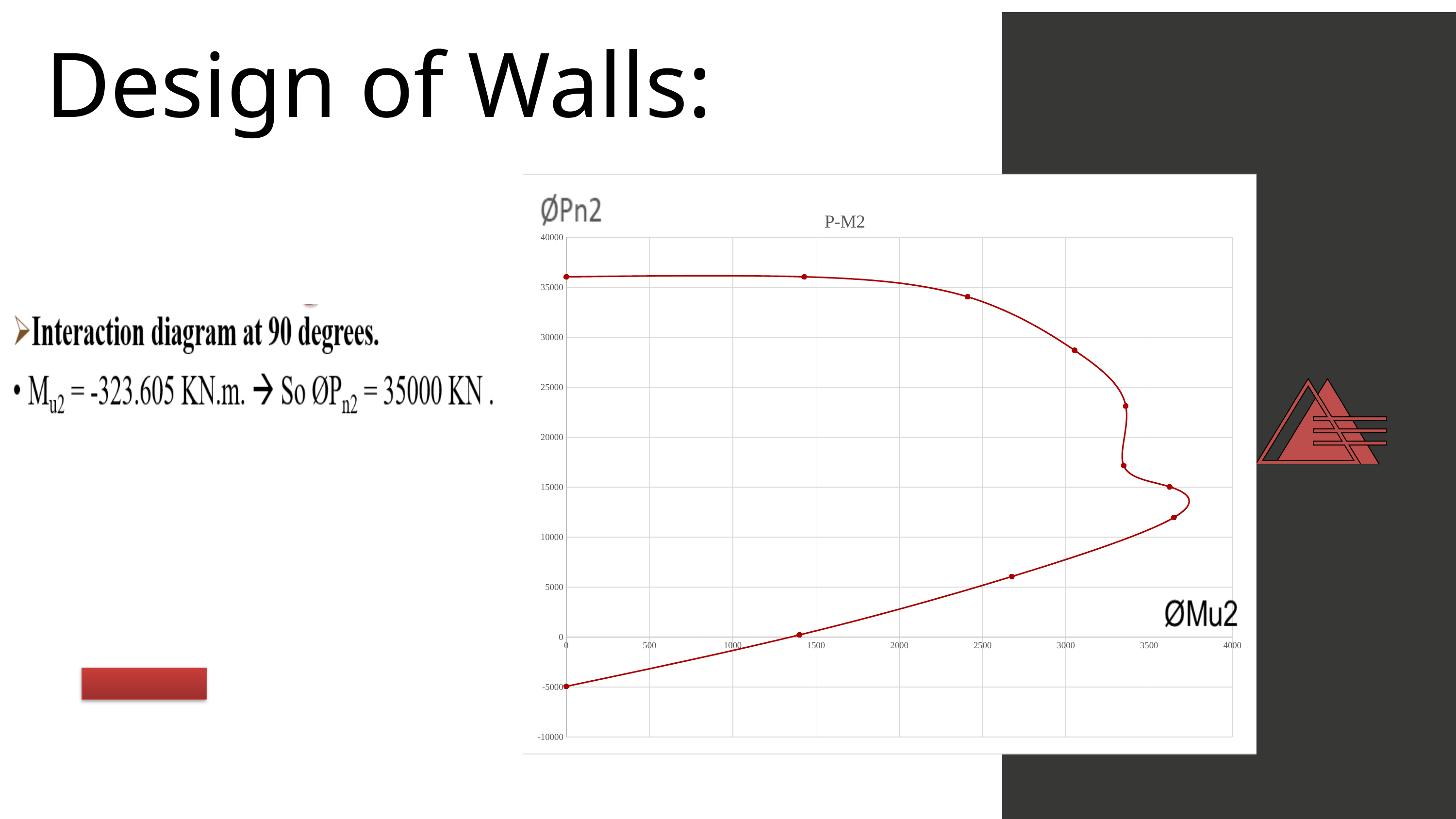
What is the title of the chart? P-M2 Which has the larger ØPn2 value: the point at ØMu2 = 0 at the top of the curve or the point at ØMu2 = 0 at the bottom of the curve? the point at the top of the curve Along the lower branch of the curve, does ØPn2 rise or fall as ØMu2 increases from 0 to about 3500? rise What kind of chart is shown on the slide? line chart Is the ØMu2 value of the point lying on the horizontal axis greater or less than 1500? less Is the largest ØMu2 value reached by the curve greater or less than 3500? greater What label is shown on the vertical axis of the chart? ØPn2 How many data points are marked on the curve? 11 What is the maximum value shown on the ØMu2 axis? 4000 Is the highest ØPn2 value on the curve greater or less than 35000? greater